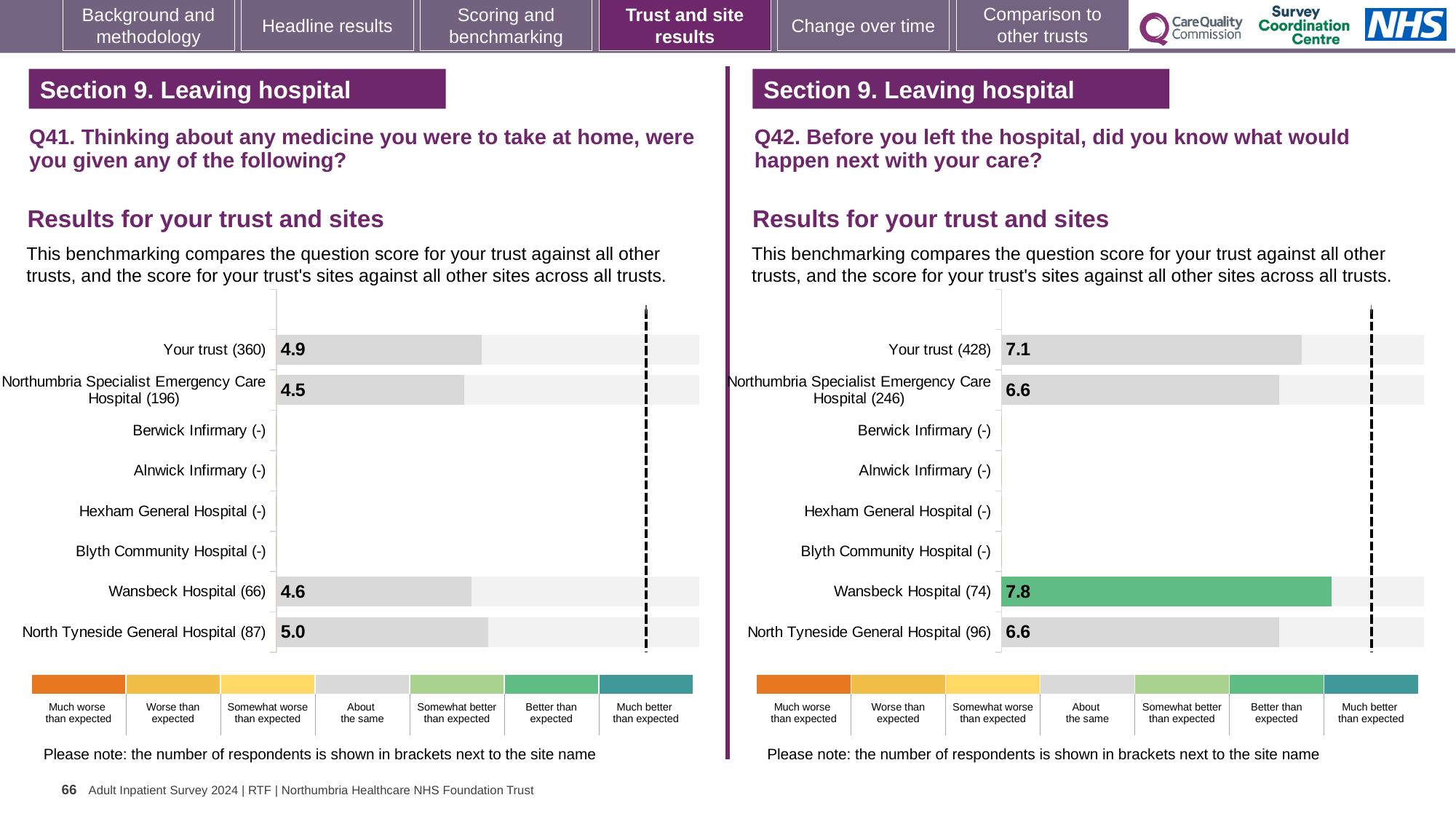
On the Q42 chart (right), which benchmark category does the green bar for Wansbeck Hospital (74) represent according to the legend? Better than expected On the Q41 chart (left), which site or trust has the lowest score shown? Northumbria Specialist Emergency Care Hospital (196) On the Q41 chart (left), what is the difference between the scores for North Tyneside General Hospital (87) and Wansbeck Hospital (66)? 0.4 On the Q42 chart (right), which site or trust has the highest score shown? Wansbeck Hospital (74) What kind of chart is used on the Q42 chart (right)? Bar chart On the Q42 chart (right), what is the score for Wansbeck Hospital (74)? 7.8 How many sites or trusts are listed on the Q41 chart (left), including those with no score? 8 On the Q42 chart (right), which is larger: the score for Your trust (428) or Northumbria Specialist Emergency Care Hospital (246)? Your trust (428) On the Q42 chart (right), what is the difference between the scores for Wansbeck Hospital (74) and North Tyneside General Hospital (96)? 1.2 On the Q42 chart (right), what is the score for Your trust (428)? 7.1 On the Q41 chart (left), what is the score for Your trust (360)? 4.9 On the Q41 chart (left), what is the score for North Tyneside General Hospital (87)? 5.0